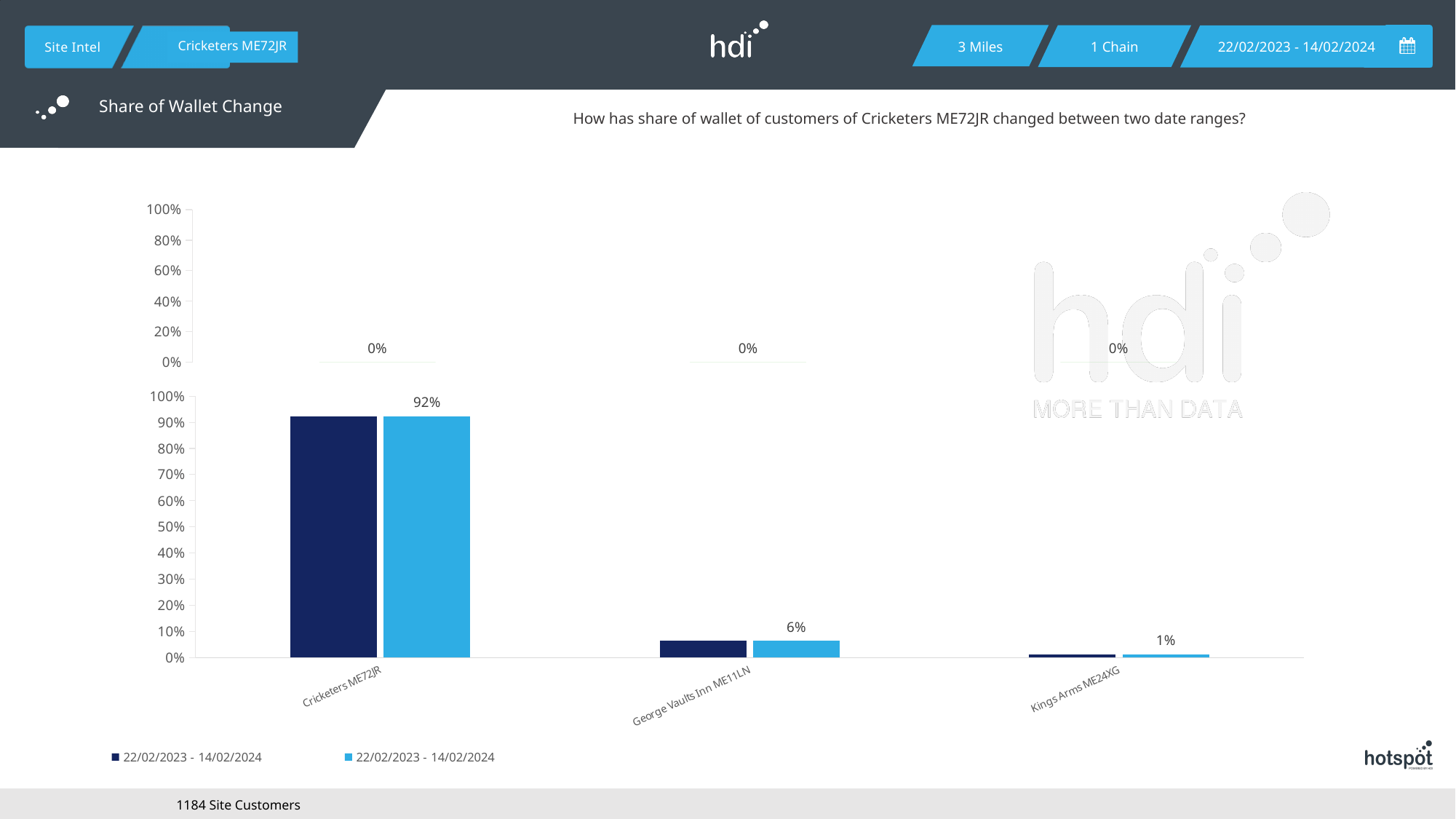
In the bottom chart, which has the larger share of wallet: George Vaults Inn ME11LN or Kings Arms ME24XG? George Vaults Inn ME11LN How many series does the legend of the bottom chart list? 2 In the bottom chart, which category has the highest share of wallet? Cricketers ME72JR In the bottom chart, which category has the lowest share of wallet? Kings Arms ME24XG What kind of chart is the bottom chart? Bar chart How many categories are shown on the x axis of the bottom chart? 3 In the top chart, what change value is shown for George Vaults Inn ME11LN? 0% In the bottom chart, what is the share of wallet value shown for George Vaults Inn ME11LN? 6% In the bottom chart, what is the share of wallet value shown for Cricketers ME72JR? 92% In the bottom chart, what is the difference between the labelled values for Cricketers ME72JR and George Vaults Inn ME11LN? 86 percentage points In the bottom chart, what is the share of wallet value shown for Kings Arms ME24XG? 1% In the bottom chart, is the value for Cricketers ME72JR greater or less than 80%? greater